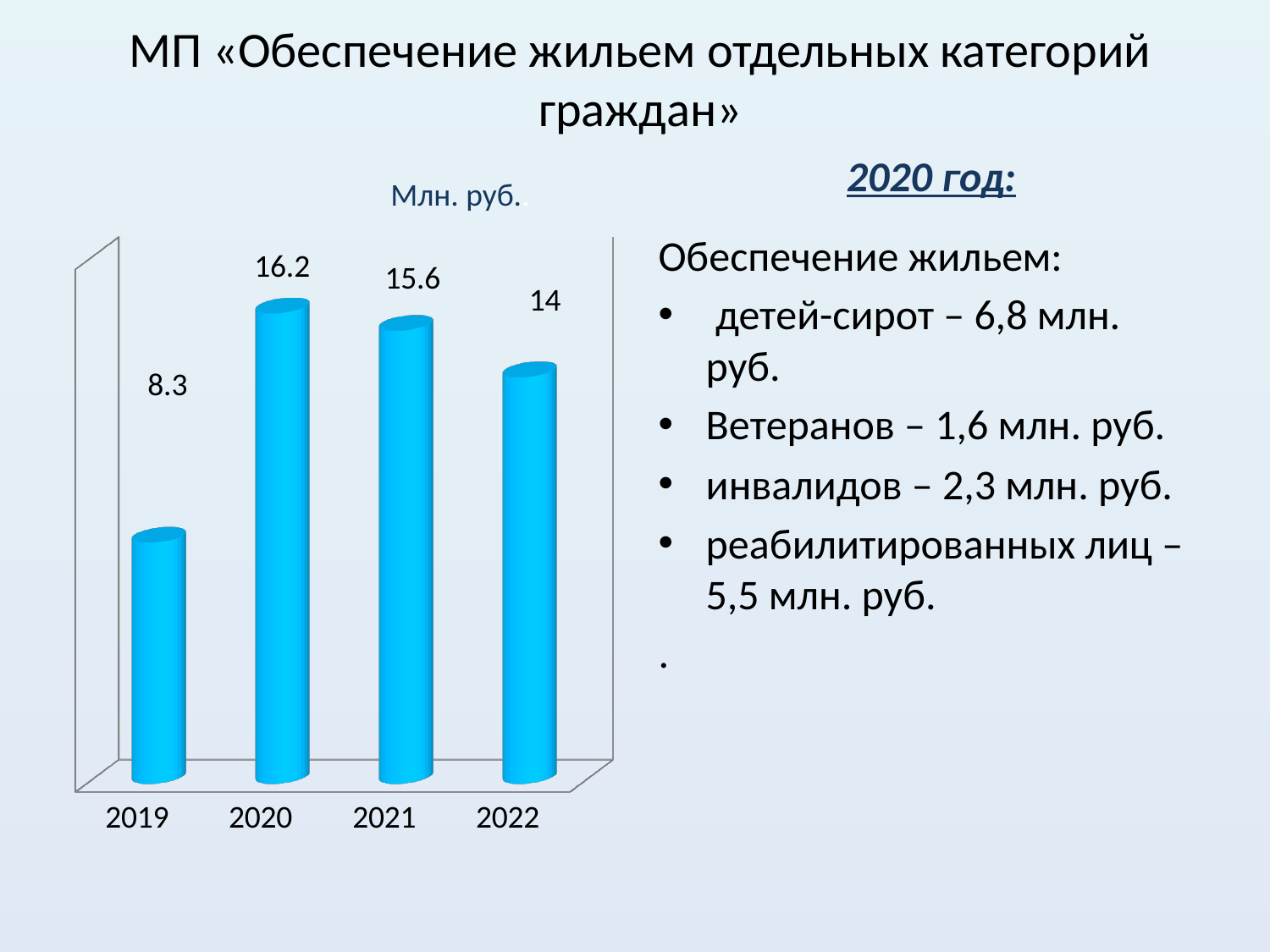
What is the value for 2022 on the chart? 14 What is the value for 2021 on the chart? 15.6 What kind of chart is shown on the slide? Bar chart Which year has the highest value on the chart? 2020 What is the value for 2020 on the chart? 16.2 What is the value for 2019 on the chart? 8.3 What is the difference between the values for 2020 and 2019? 7.9 What is the title of the chart? Млн. руб. How many years are shown on the chart? 4 What is the difference between the values for 2021 and 2022? 1.6 Which is larger, the value for 2021 or the value for 2022? 2021 Which year has the lowest value on the chart? 2019